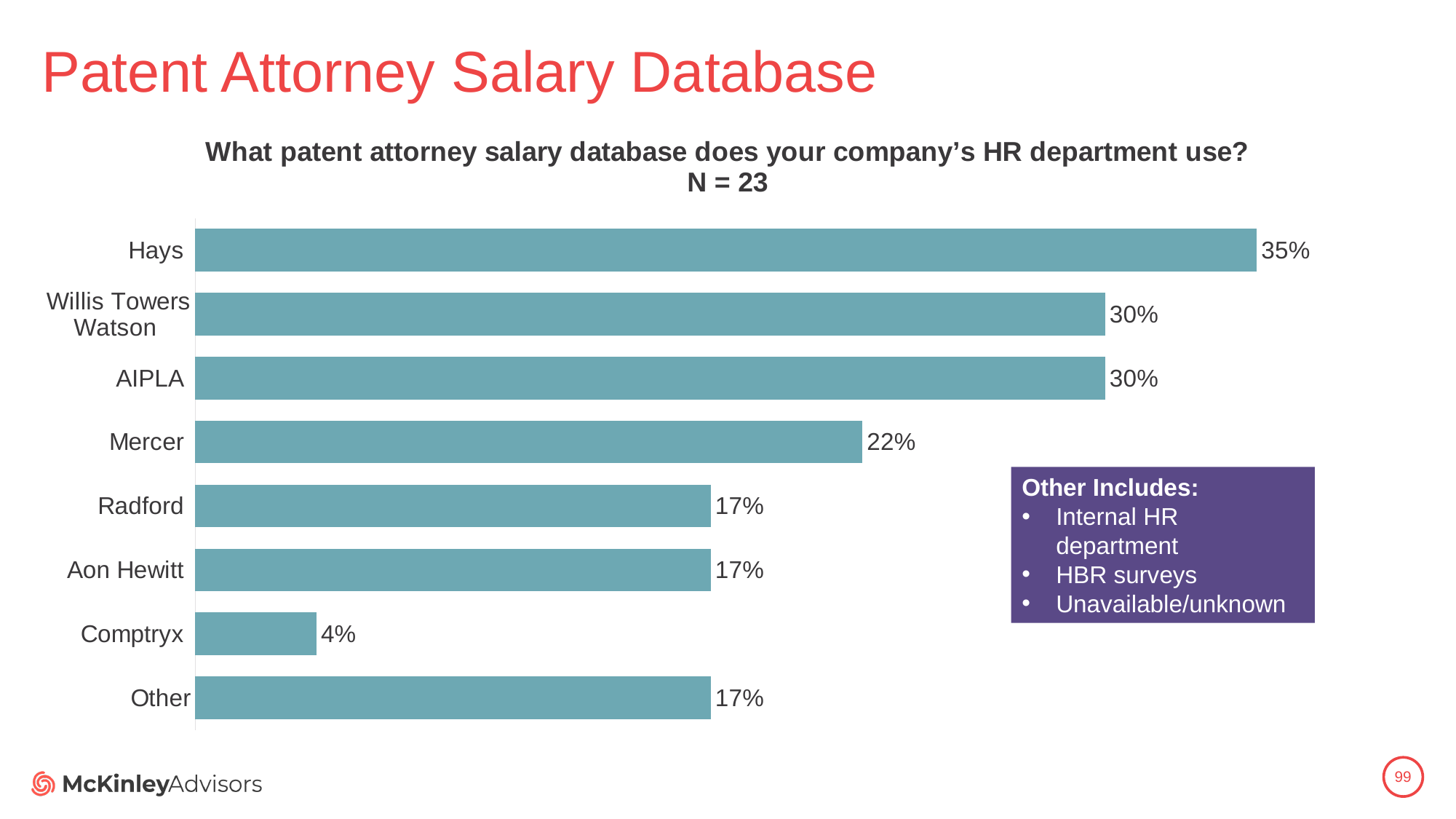
What percentage is shown for Comptryx? 4% Which is larger, the value for Mercer or the value for Radford? Mercer What is the value shown for Mercer? 22% What is the difference between AIPLA and Comptryx? 26% Which category has the lowest percentage? Comptryx What is the difference in percentage points between Hays and Mercer? 13 What type of chart is shown on the slide? Bar chart What is the value for Willis Towers Watson? 30% What is the sample size (N) stated in the chart title? 23 What percentage of respondents use Hays as their patent attorney salary database? 35% How many categories are shown in the chart? 8 Which salary database has the highest percentage? Hays